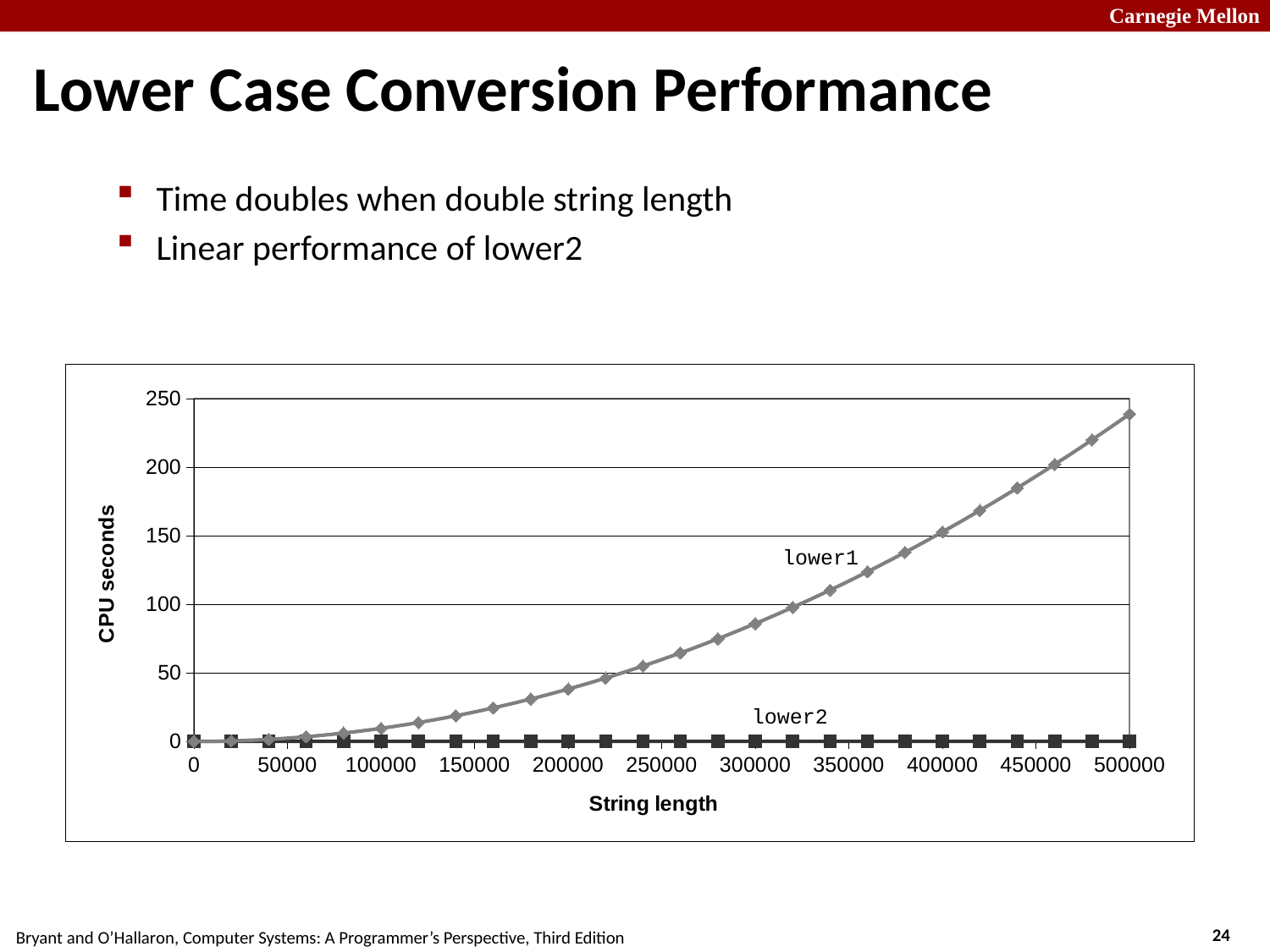
What is the largest string length shown on the x axis? 500000 Is the value of lower2 at a string length of 500000 greater or less than 50? less What is the label of the x axis? String length Which series has the larger value at a string length of 500000, lower1 or lower2? lower1 Is the value of lower1 at a string length of 200000 greater or less than 50? less What kind of chart is shown on the slide? line chart How many data series are plotted on the chart? 2 Does the lower1 series rise or fall as string length increases? rise Which series reaches the highest CPU seconds on the chart? lower1 Is the value of lower1 at a string length of 500000 greater or less than 200? greater What is the label of the y axis? CPU seconds